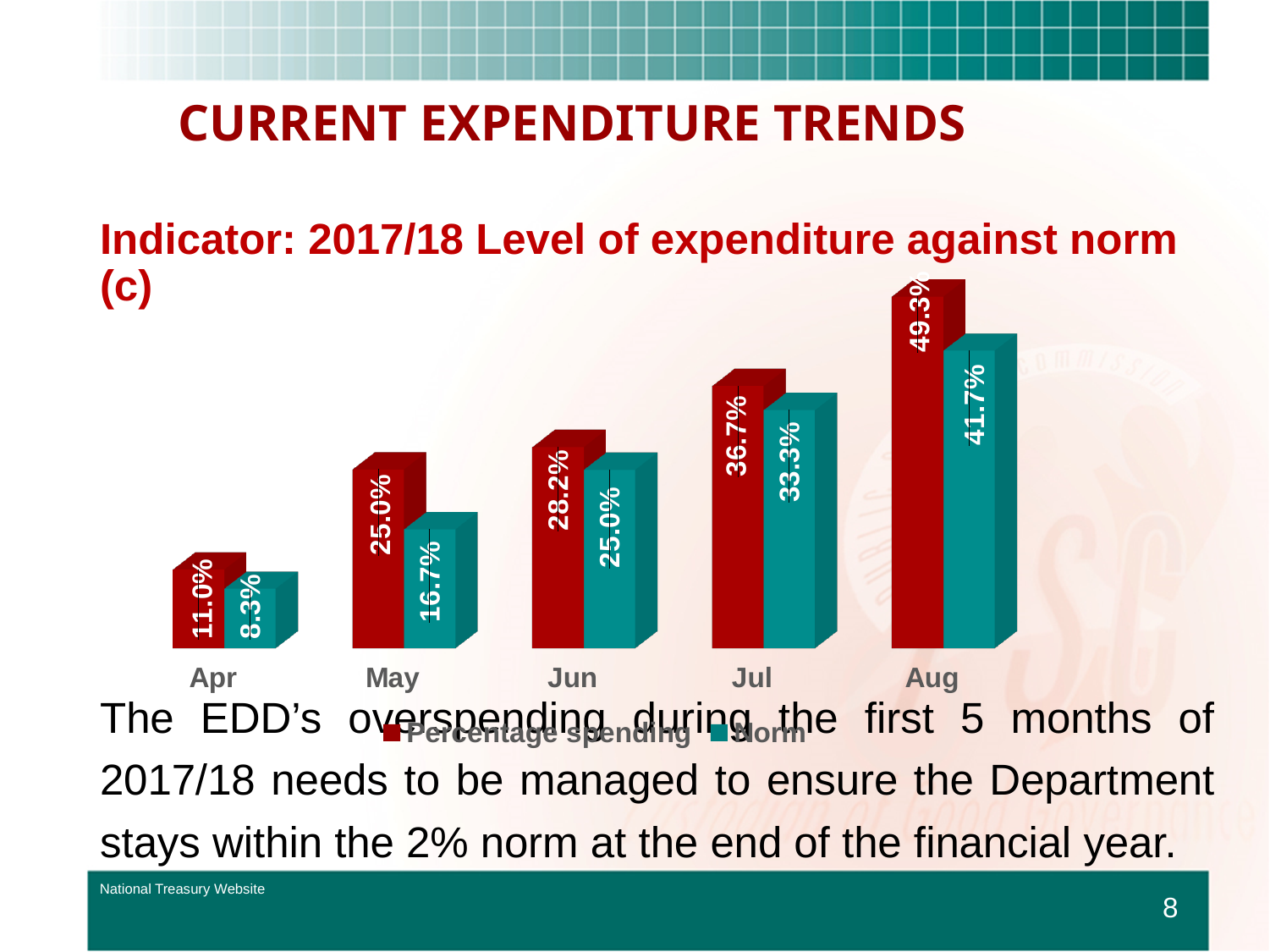
What is the Norm value for Jul? 33.3% How many months are shown on the x axis? 5 What is the Percentage spending value for May? 25.0% In Jun, which is larger: Percentage spending or Norm? Percentage spending What is the Percentage spending value for Aug? 49.3% How many series does the legend list? 2 What is the difference between Percentage spending and Norm in May? 8.3% What is the difference between Percentage spending and Norm in Aug? 7.6% Which month has the highest Percentage spending value? Aug What is the Norm value for Apr? 8.3% Which month has the lowest Norm value? Apr Do the Norm values rise or fall from Apr to Aug? rise